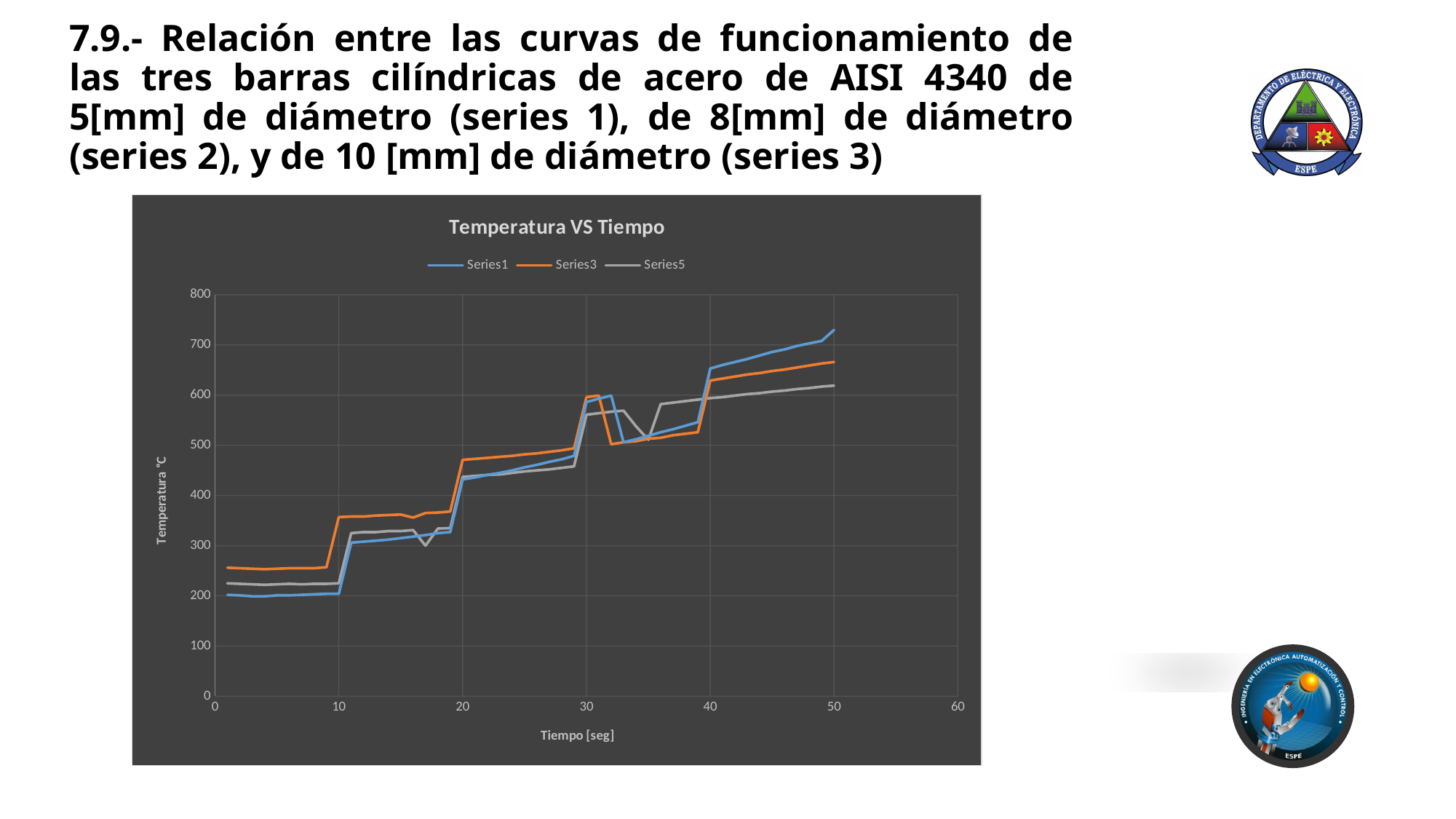
Is the value of Series3 at time 50 seconds greater or less than 700? less Which series has the lowest temperature at time 50 seconds? Series5 What is the title of the chart? Temperatura VS Tiempo Which series has the highest temperature at time 50 seconds? Series1 What type of chart is shown on the slide? Line chart At time 25 seconds, which is higher: Series3 or Series5? Series3 What is the label of the horizontal axis of the chart? Tiempo [seg] At time 5 seconds, which is higher: Series1 or Series3? Series3 Is the value of Series1 at time 50 seconds greater or less than 700? greater How many series does the legend of the chart list? 3 Is the value of Series5 at time 50 seconds greater or less than 600? greater Do the temperature values of Series1 generally rise or fall as time increases? Rise